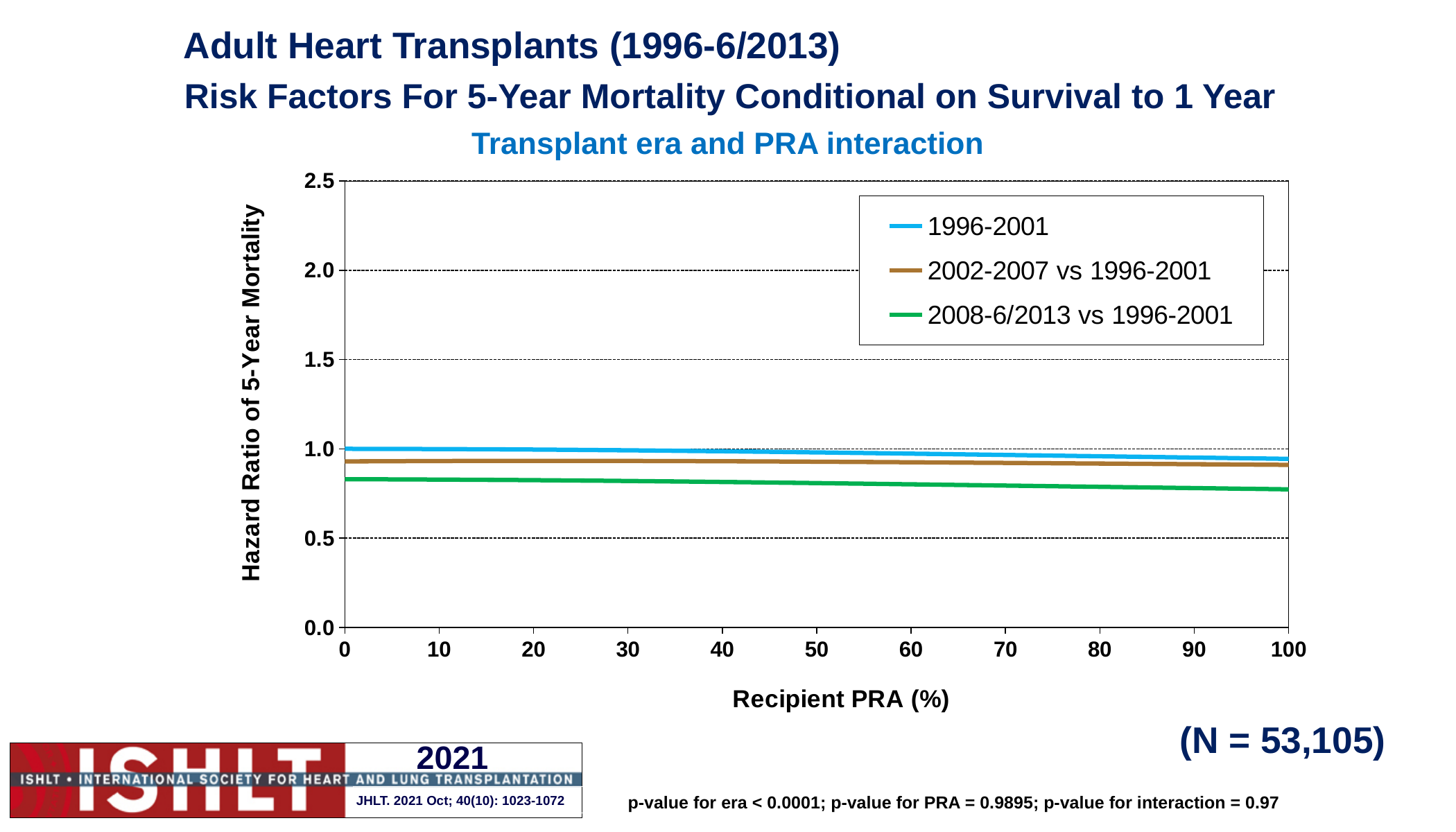
What is the subtitle of the chart shown in blue? Transplant era and PRA interaction Which series has a higher hazard ratio at a recipient PRA of 50%: 2002-2007 vs 1996-2001 or 2008-6/2013 vs 1996-2001? 2002-2007 vs 1996-2001 Is the hazard ratio for the 2008-6/2013 vs 1996-2001 series at a recipient PRA of 100% greater or less than 1.5? less Which series has the lowest hazard ratio across the range of recipient PRA? 2008-6/2013 vs 1996-2001 Does the hazard ratio for the 2008-6/2013 vs 1996-2001 series rise or fall as recipient PRA increases from 0 to 100? Fall Is the hazard ratio for the 2008-6/2013 vs 1996-2001 series greater or less than 1.0? less How many series does the legend list? 3 Is the hazard ratio for the 2002-2007 vs 1996-2001 series at a recipient PRA of 100% greater or less than 0.5? greater Which series has the highest hazard ratio across the range of recipient PRA? 1996-2001 What is the label of the y axis? Hazard Ratio of 5-Year Mortality What kind of chart is shown on the slide? Line chart